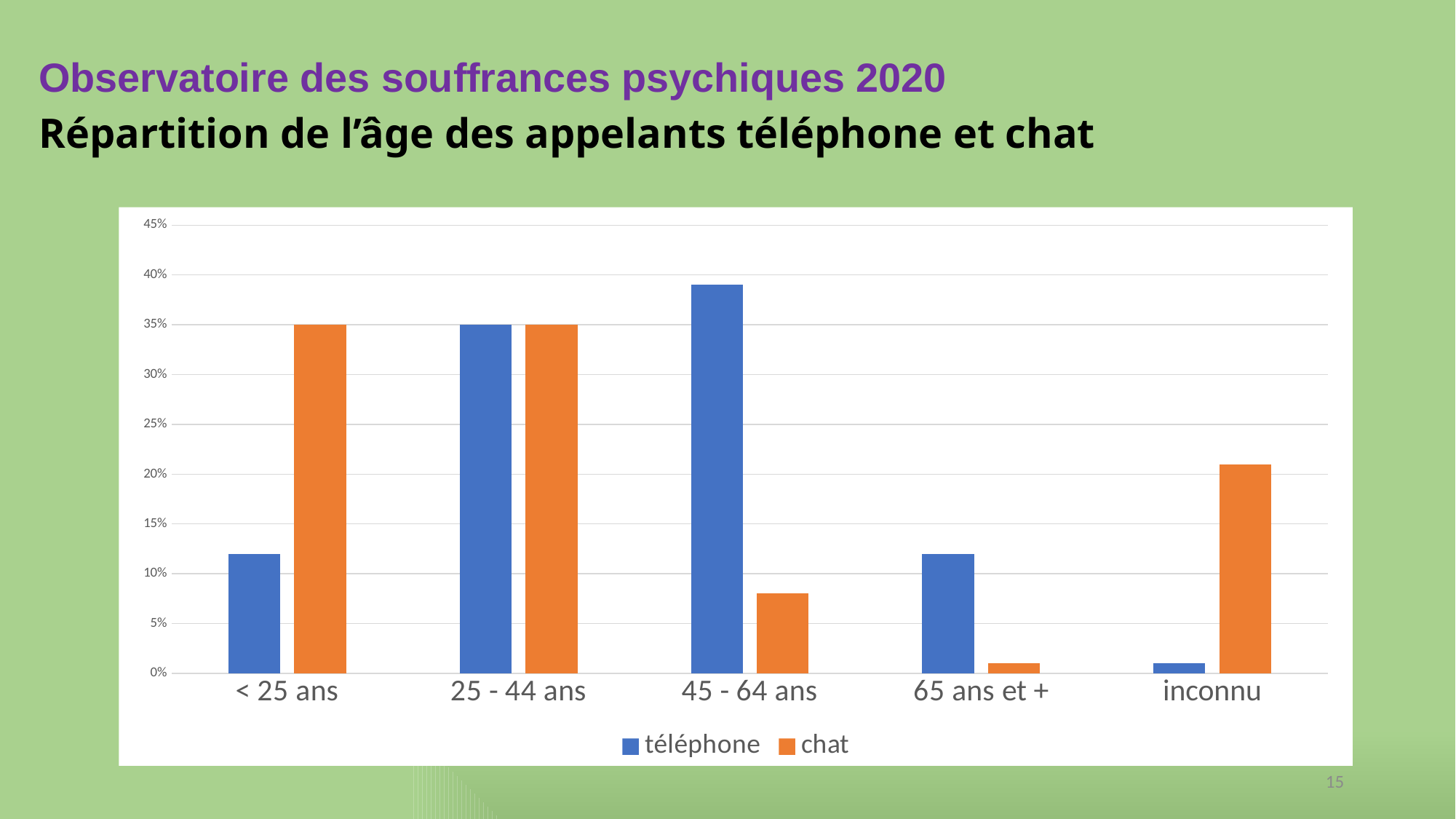
Which age category has the lowest value for téléphone? inconnu Which series are listed in the legend? téléphone and chat What is the value for téléphone in the '25 - 44 ans' category? 35% Is the value for chat in the 'inconnu' category greater or less than 20%? greater How many series does the legend list? 2 In the '< 25 ans' category, which is larger, téléphone or chat? chat How many age categories are shown on the x axis? 5 In the '45 - 64 ans' category, which is larger, téléphone or chat? téléphone Which age category has the highest value for téléphone? 45 - 64 ans What is the value for chat in the '< 25 ans' category? 35% Which age category has the lowest value for chat? 65 ans et + What kind of chart is shown on the slide? bar chart